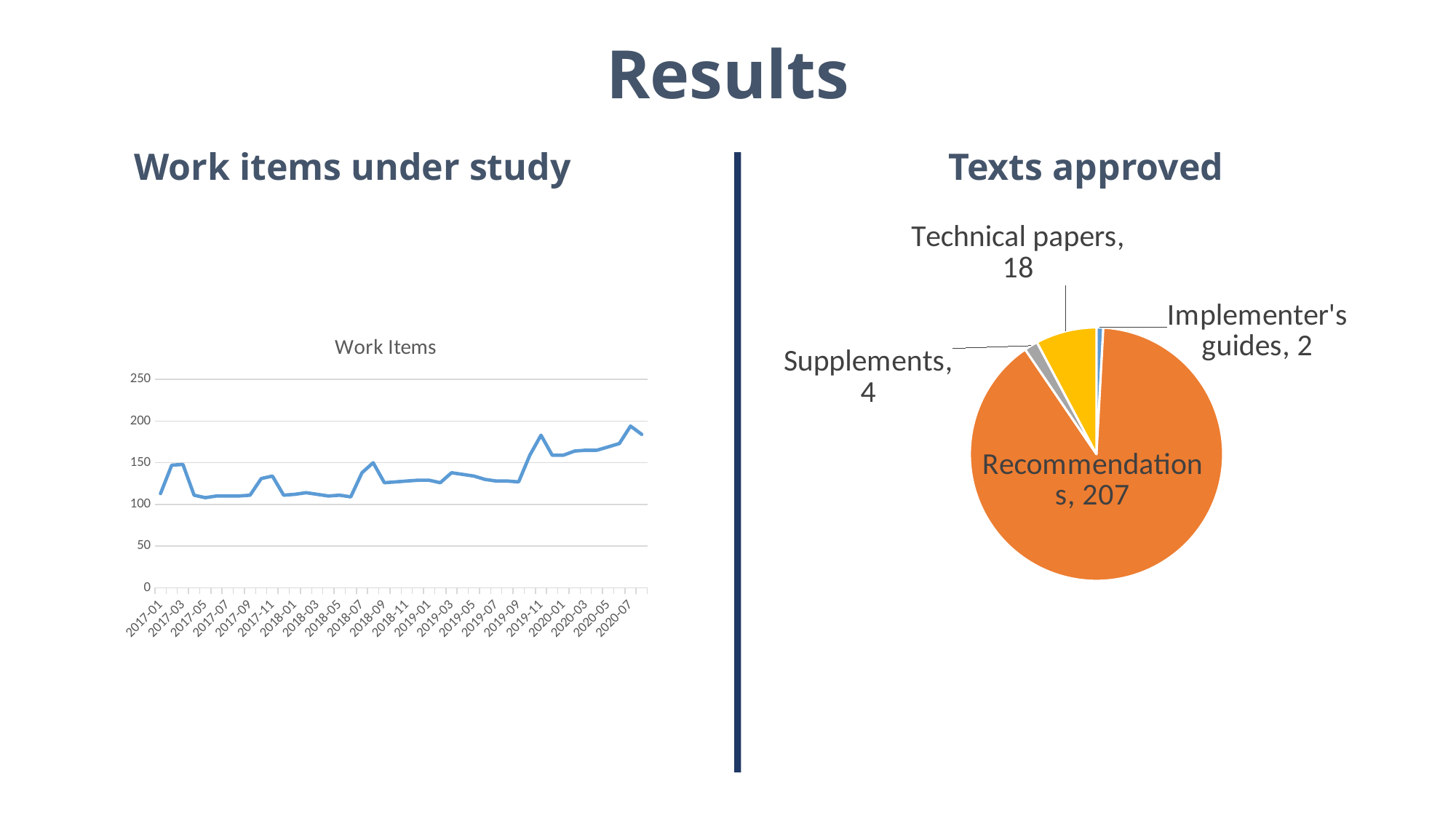
In the 'Texts approved' pie chart, what is the value for Supplements? 4 In the 'Work Items' line chart, is the value for 2017-01 greater or less than 100? greater In the 'Texts approved' pie chart, how many categories are shown? 4 What kind of chart is shown under 'Texts approved' on the right? pie chart In the 'Texts approved' pie chart, which category has the largest slice? Recommendations What kind of chart is the 'Work Items' chart on the left? line chart In the 'Work Items' line chart, is the value for 2019-11 greater or less than 150? greater In the 'Texts approved' pie chart, what is the value for Technical papers? 18 In the 'Work Items' line chart, do the values generally rise or fall from 2017-01 to 2020-07? rise In the 'Texts approved' pie chart, how many more Technical papers are there than Supplements? 14 In the 'Texts approved' pie chart, how many texts are Recommendations? 207 In the 'Texts approved' pie chart, which category has the smallest slice? Implementer's guides